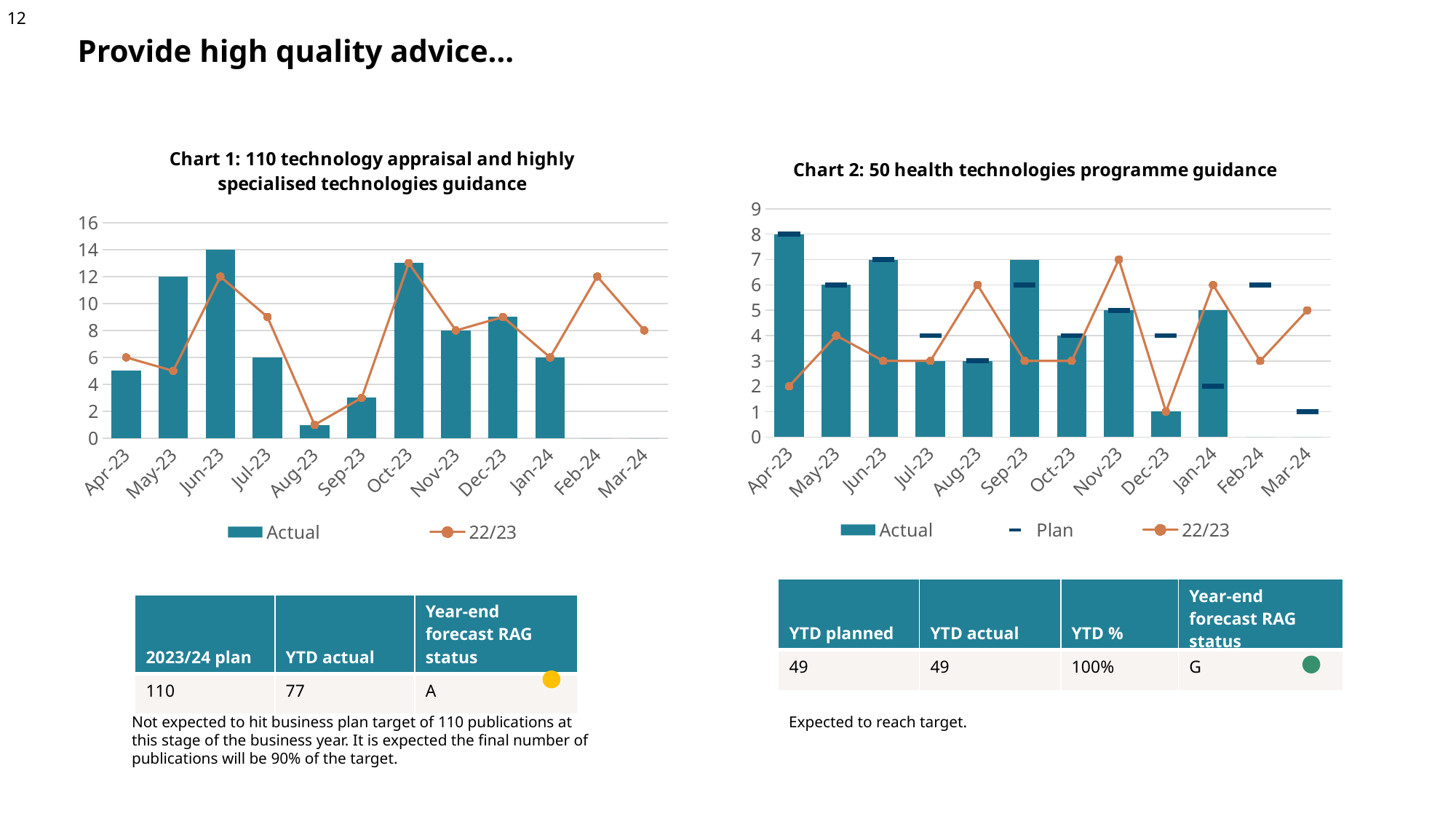
In Chart 2: 50 health technologies programme guidance, which month has the lowest Actual bar? Dec-23 How many series does the legend of Chart 1: 110 technology appraisal and highly specialised technologies guidance list? 2 In Chart 1: 110 technology appraisal and highly specialised technologies guidance, which month has the highest Actual bar? Jun-23 What kind of chart is Chart 1: 110 technology appraisal and highly specialised technologies guidance? Bar chart with a line In Chart 2: 50 health technologies programme guidance, what is the difference between the Actual values for Apr-23 and Dec-23? 7 In Chart 1: 110 technology appraisal and highly specialised technologies guidance, is the Actual value for Oct-23 greater or less than 12? greater In Chart 2: 50 health technologies programme guidance, what is the Actual value for Apr-23? 8 In Chart 1: 110 technology appraisal and highly specialised technologies guidance, which month has the lowest Actual bar? Aug-23 How many series does the legend of Chart 2: 50 health technologies programme guidance list? 3 In Chart 2: 50 health technologies programme guidance, what is the Plan value for Dec-23? 4 In Chart 2: 50 health technologies programme guidance, which is larger, the Actual value for Sep-23 or for Oct-23? Sep-23 In Chart 1: 110 technology appraisal and highly specialised technologies guidance, what is the Actual value for Jun-23? 14